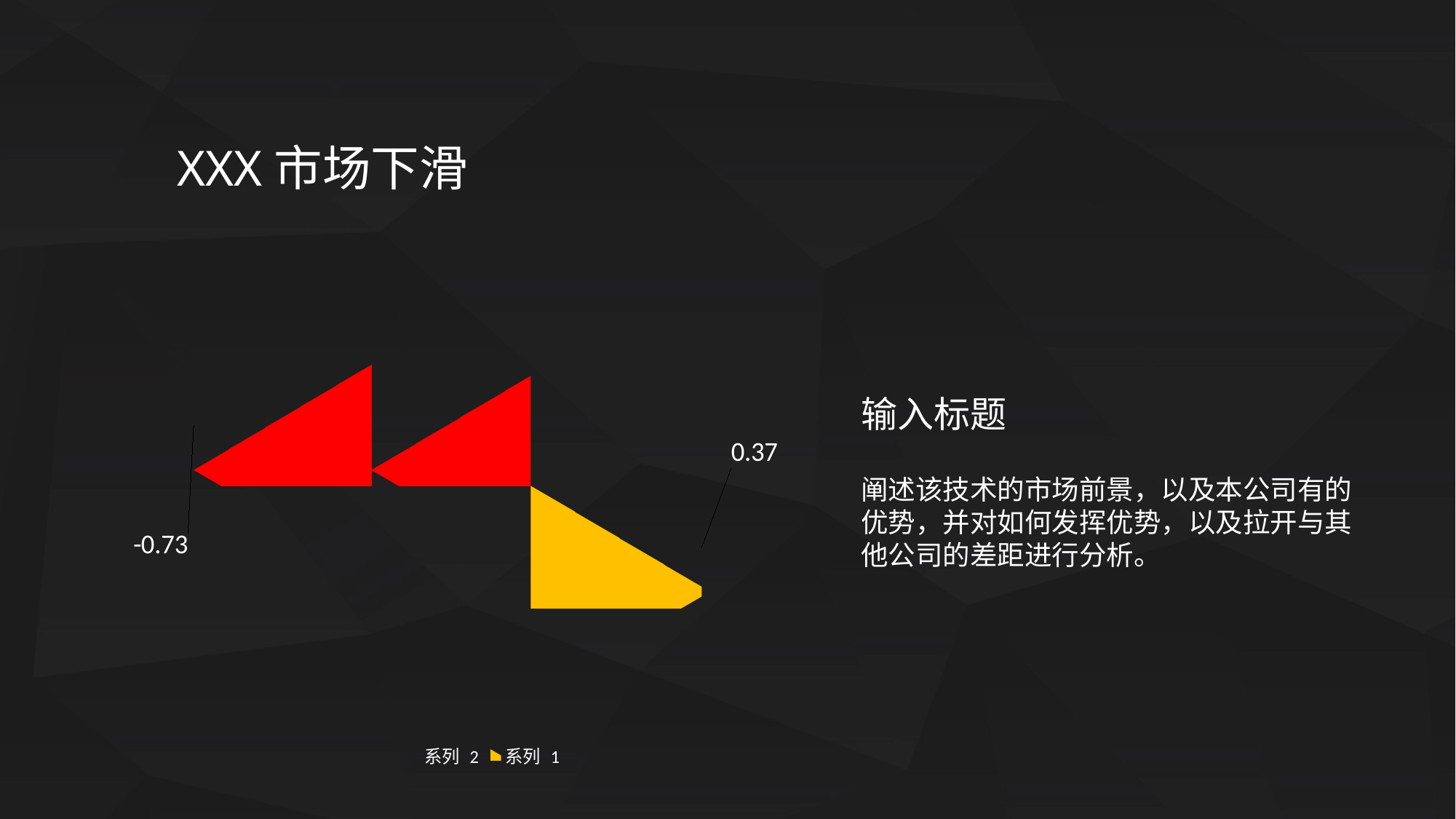
How many data labels are printed on the chart? 2 Is the labelled value 0.37 greater or less than 0? greater Which colour is used for 系列 1 in the chart legend? Yellow What is the negative value printed as a data label on the chart? -0.73 How many series does the chart legend list? 2 Is the labelled value -0.73 greater or less than 0? less What is the difference between the two labelled values, 0.37 and -0.73? 1.10 What are the two series names shown in the chart legend? 系列 2 and 系列 1 Which of the two labelled values is larger, 0.37 or -0.73? 0.37 What value is printed as the data label on the yellow shape (系列 1)? 0.37